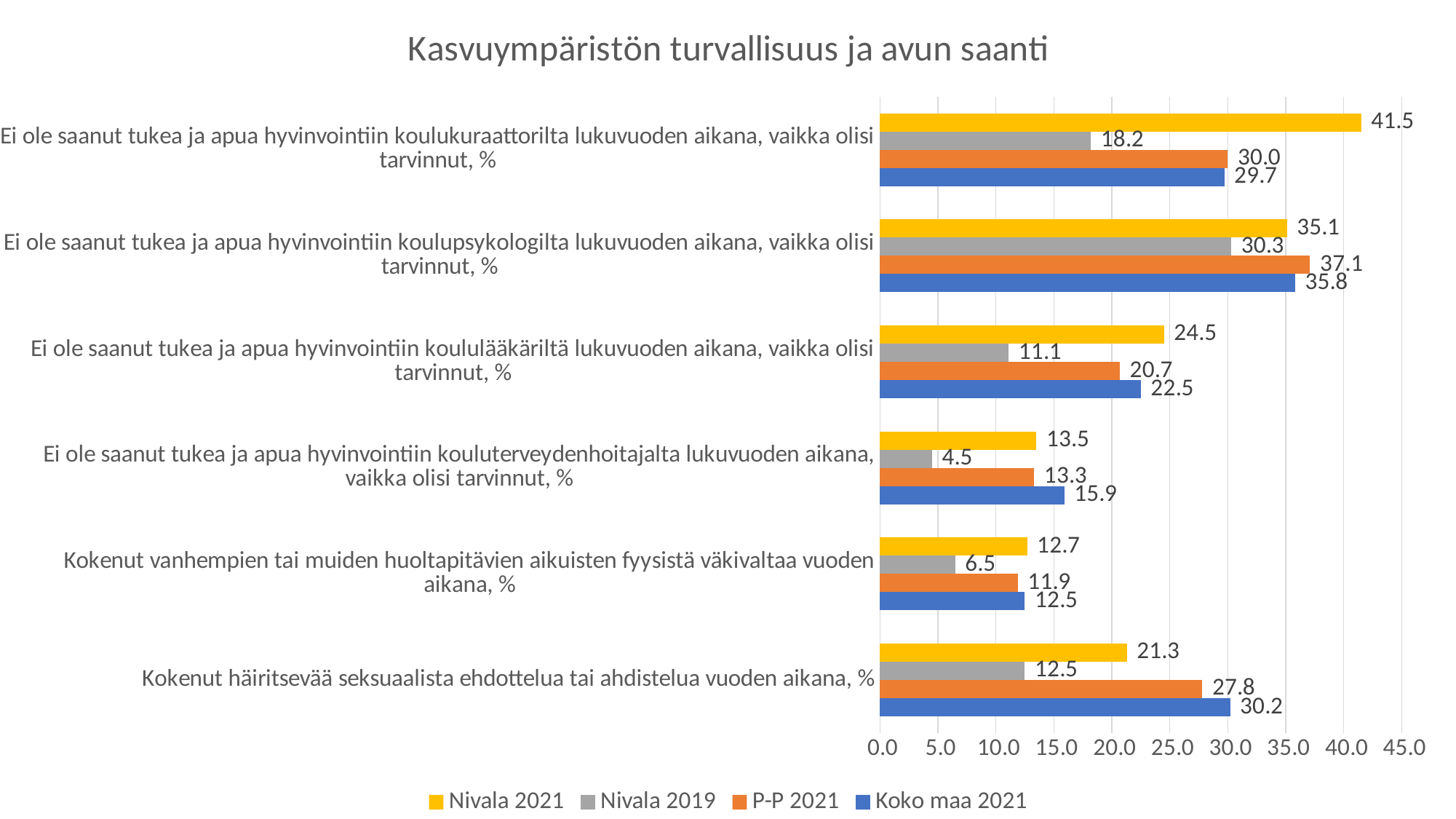
How many categories are shown on the chart? 6 Which category has the highest Nivala 2021 value? Ei ole saanut tukea ja apua hyvinvointiin koulukuraattorilta lukuvuoden aikana, vaikka olisi tarvinnut, % What is the difference between the Nivala 2021 and Nivala 2019 values for 'Ei ole saanut tukea ja apua hyvinvointiin koulukuraattorilta lukuvuoden aikana, vaikka olisi tarvinnut, %'? 23.3 What is the Nivala 2021 value for 'Ei ole saanut tukea ja apua hyvinvointiin koulukuraattorilta lukuvuoden aikana, vaikka olisi tarvinnut, %'? 41.5 How many series does the legend list? 4 For 'Kokenut häiritsevää seksuaalista ehdottelua tai ahdistelua vuoden aikana, %', which is larger: the Nivala 2021 value or the P-P 2021 value? P-P 2021 What type of chart is shown on the slide? Bar chart Which category has the lowest Nivala 2019 value? Ei ole saanut tukea ja apua hyvinvointiin kouluterveydenhoitajalta lukuvuoden aikana, vaikka olisi tarvinnut, % What is the Koko maa 2021 value for 'Kokenut häiritsevää seksuaalista ehdottelua tai ahdistelua vuoden aikana, %'? 30.2 What is the Nivala 2019 value for 'Ei ole saanut tukea ja apua hyvinvointiin kouluterveydenhoitajalta lukuvuoden aikana, vaikka olisi tarvinnut, %'? 4.5 What is the title of the chart? Kasvuympäristön turvallisuus ja avun saanti Is the P-P 2021 value for 'Ei ole saanut tukea ja apua hyvinvointiin koulupsykologilta lukuvuoden aikana, vaikka olisi tarvinnut, %' greater or less than 35.0? greater